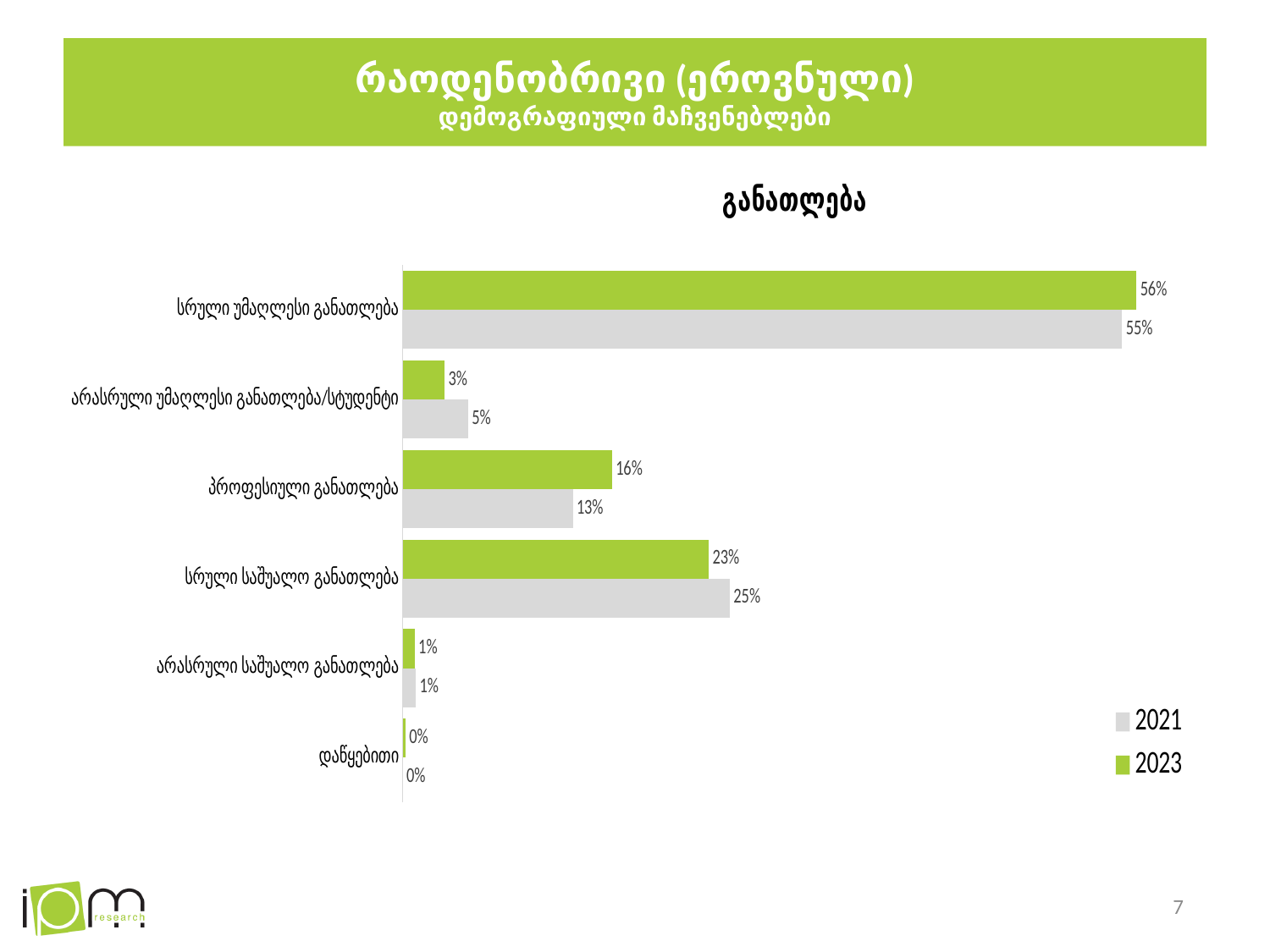
What is the difference between the 2023 and 2021 values for პროფესიული განათლება? 3% Which is larger for სრული საშუალო განათლება, the 2021 value or the 2023 value? 2021 Which category has the highest 2023 value? სრული უმაღლესი განათლება What is the 2023 value for პროფესიული განათლება? 16% What is the 2021 value for არასრული უმაღლესი განათლება/სტუდენტი? 5% How many categories are shown in the chart? 6 What is the 2021 value for სრული საშუალო განათლება? 25% How many series does the legend list? 2 What type of chart is shown on the slide? Bar chart What is the 2023 value for სრული უმაღლესი განათლება? 56% Which category has the lowest 2021 value? დაწყებითი What is the 2021 value for სრული უმაღლესი განათლება? 55%